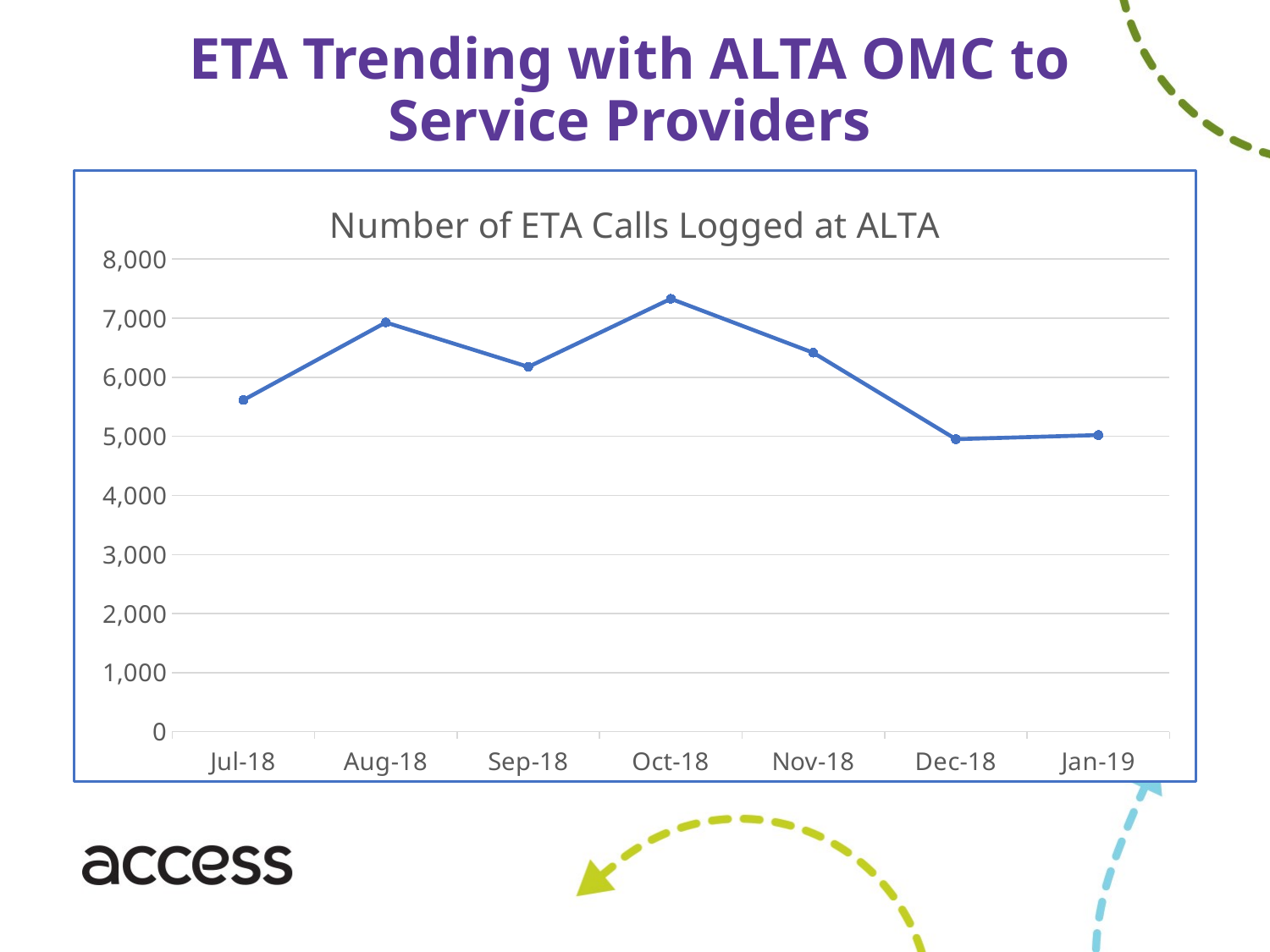
Is the value for Oct-18 greater or less than 7,000? greater Which month has the highest number of ETA calls logged? Oct-18 Is the value for Nov-18 greater or less than 7,000? less How many months are plotted on the x axis? 7 Which is larger, the value for Aug-18 or the value for Sep-18? Aug-18 What kind of chart is shown on the slide? line chart Is the value for Dec-18 greater or less than 6,000? less What is the title of the chart? Number of ETA Calls Logged at ALTA Do the values rise or fall from Oct-18 to Dec-18? fall Which is larger, the value for Oct-18 or the value for Jan-19? Oct-18